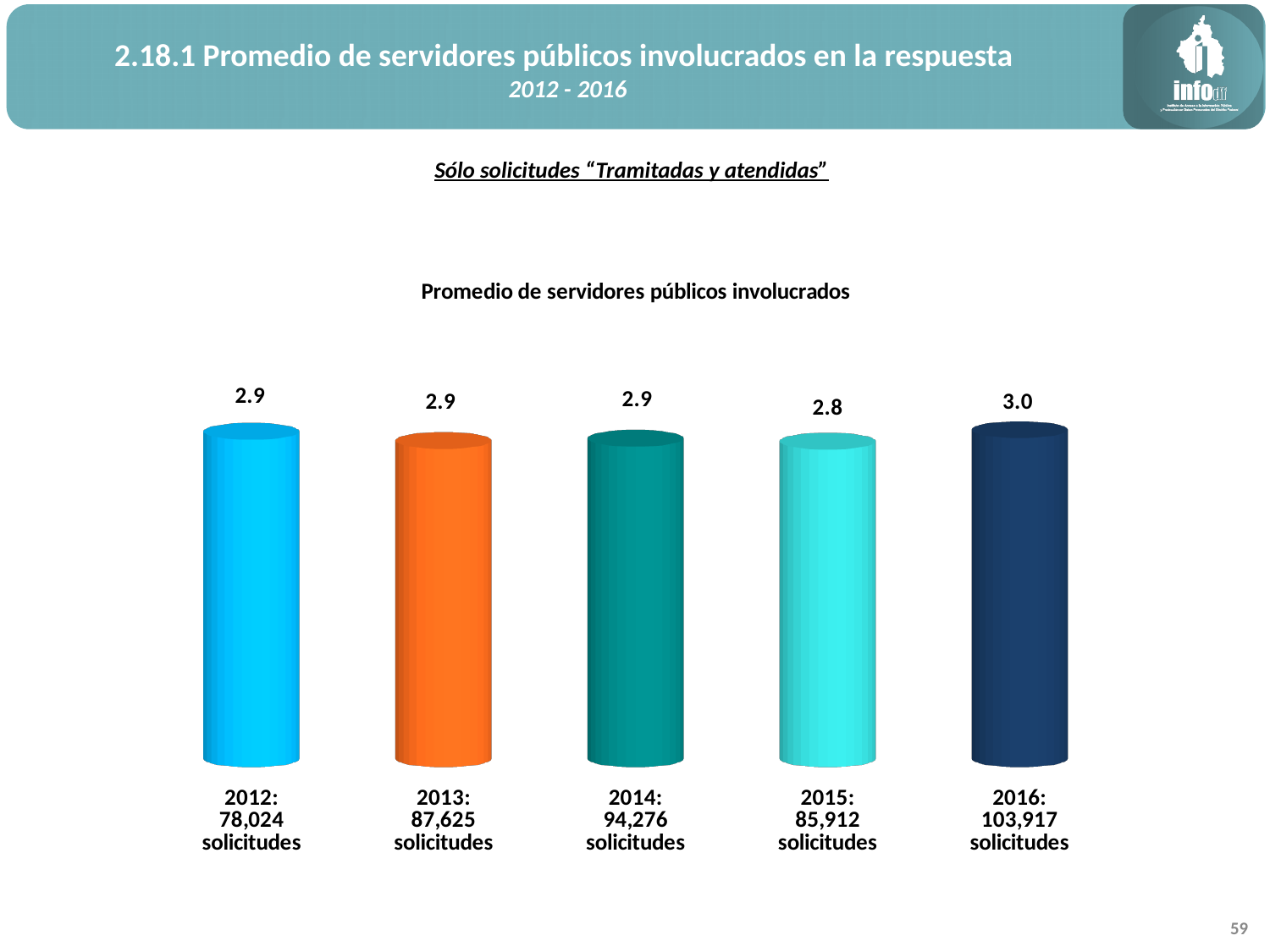
How many years are shown in the chart? 5 What is the average number of public servants involved for 2012? 2.9 Which year has the lowest average number of public servants involved? 2015 What is the average number of public servants involved for 2016? 3.0 What is the average number of public servants involved for 2015? 2.8 How many solicitudes are listed under the 2016 bar? 103,917 What is the difference between the values for 2016 and 2015? 0.2 What is the value shown for 2014? 2.9 What is the title of the chart? Promedio de servidores públicos involucrados Which year has the highest average number of public servants involved? 2016 Which is larger, the value for 2013 or the value for 2015? 2013 What kind of chart is shown on the slide? Bar chart